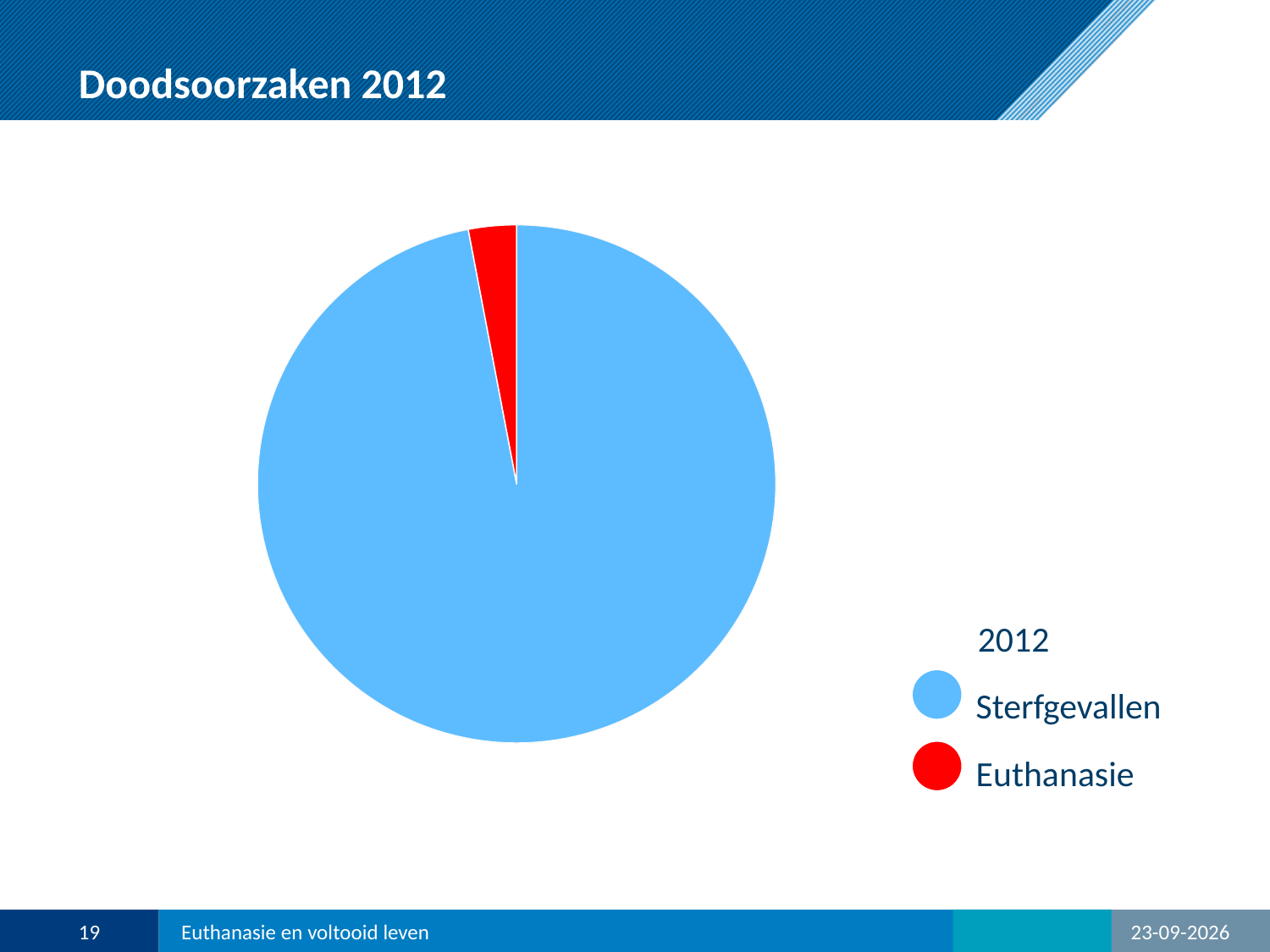
What colour is the Euthanasie slice in the pie chart? red What is the title shown above the legend of the pie chart? 2012 Which category has the smallest slice of the pie chart? Euthanasie Which slice is smaller, Euthanasie or Sterfgevallen? Euthanasie Which slice is larger, Sterfgevallen or Euthanasie? Sterfgevallen How many entries does the legend of the pie chart list? 2 What kind of chart is shown on the slide? pie chart How many slices does the pie chart have? 2 Which category has the largest slice of the pie chart? Sterfgevallen